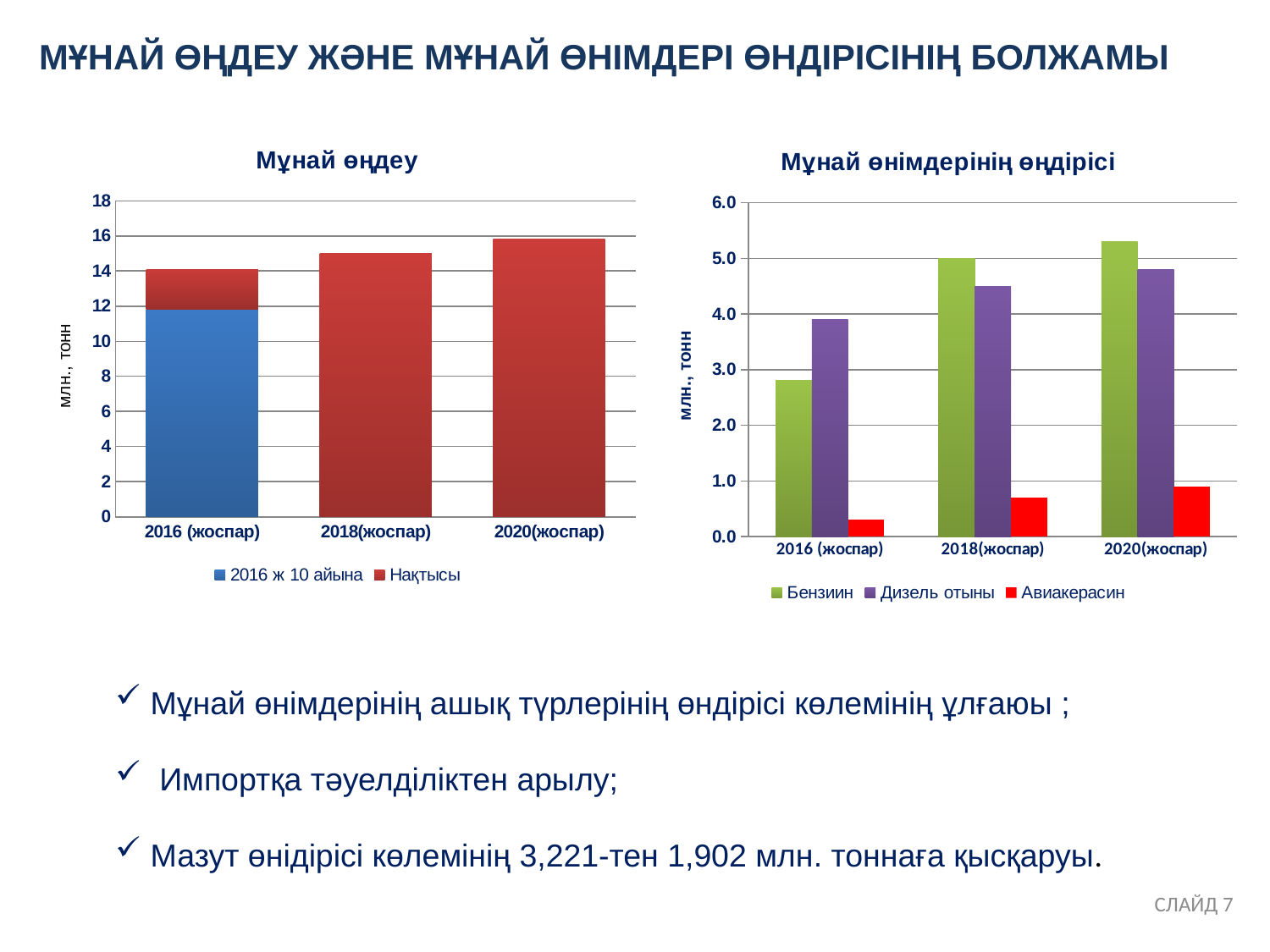
How many series does the legend of the "Мұнай өнімдерінің өндірісі" chart list? 3 In the "Мұнай өнімдерінің өндірісі" chart, which series has the lowest value in every year? Авиакерасин How many series does the legend of the "Мұнай өңдеу" chart list? 2 In the "Мұнай өңдеу" chart, is the value for 2020(жоспар) greater or less than 14? greater In the "Мұнай өнімдерінің өндірісі" chart, is the Авиакерасин value for 2020(жоспар) greater or less than 1.0? less What kind of chart is the "Мұнай өңдеу" chart on the left? bar chart In the "Мұнай өнімдерінің өндірісі" chart, is the Бензиин value for 2018(жоспар) greater or less than 4.0? greater In the "Мұнай өңдеу" chart, do the "Нақтысы" values rise or fall from 2016 (жоспар) to 2020(жоспар)? rise In the "Мұнай өнімдерінің өндірісі" chart, which is larger for 2016 (жоспар): Бензиин or Дизель отыны? Дизель отыны How many categories are shown on the x axis of the "Мұнай өңдеу" chart? 3 What is the y-axis label of the "Мұнай өнімдерінің өндірісі" chart? млн., тонн